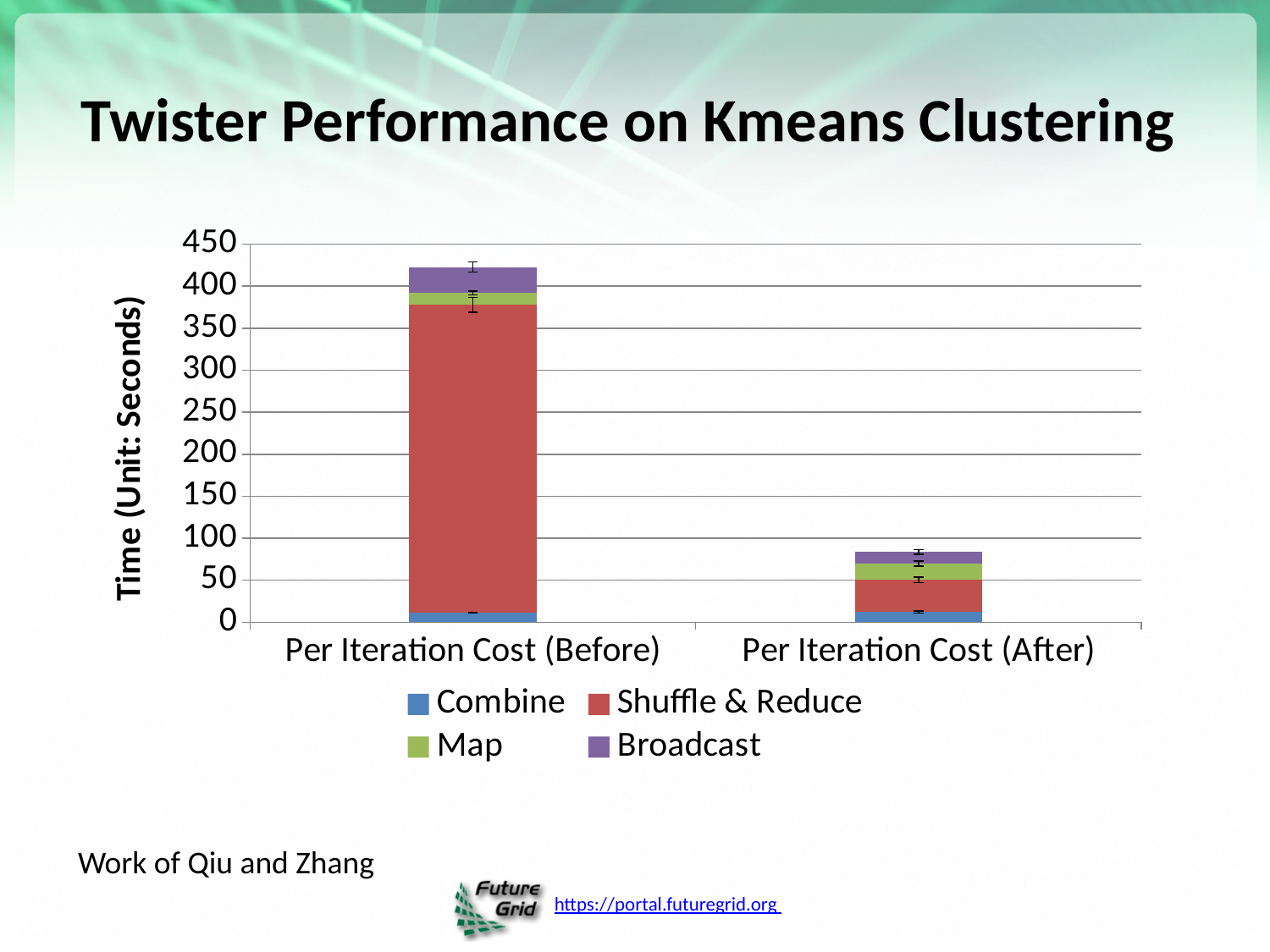
Is the Shuffle & Reduce segment for Per Iteration Cost (Before) greater or less than 300? greater How many series does the legend list? 4 What kind of chart is shown on the slide? stacked bar chart How many categories are shown on the x axis? 2 Is the total value for Per Iteration Cost (Before) greater or less than 400? greater Is the Combine segment for Per Iteration Cost (Before) greater or less than 50? less Which category has the higher total bar, Per Iteration Cost (Before) or Per Iteration Cost (After)? Per Iteration Cost (Before) Which category has the lowest total bar? Per Iteration Cost (After) What is the label of the y axis? Time (Unit: Seconds) What is the title of the chart on the slide? Twister Performance on Kmeans Clustering